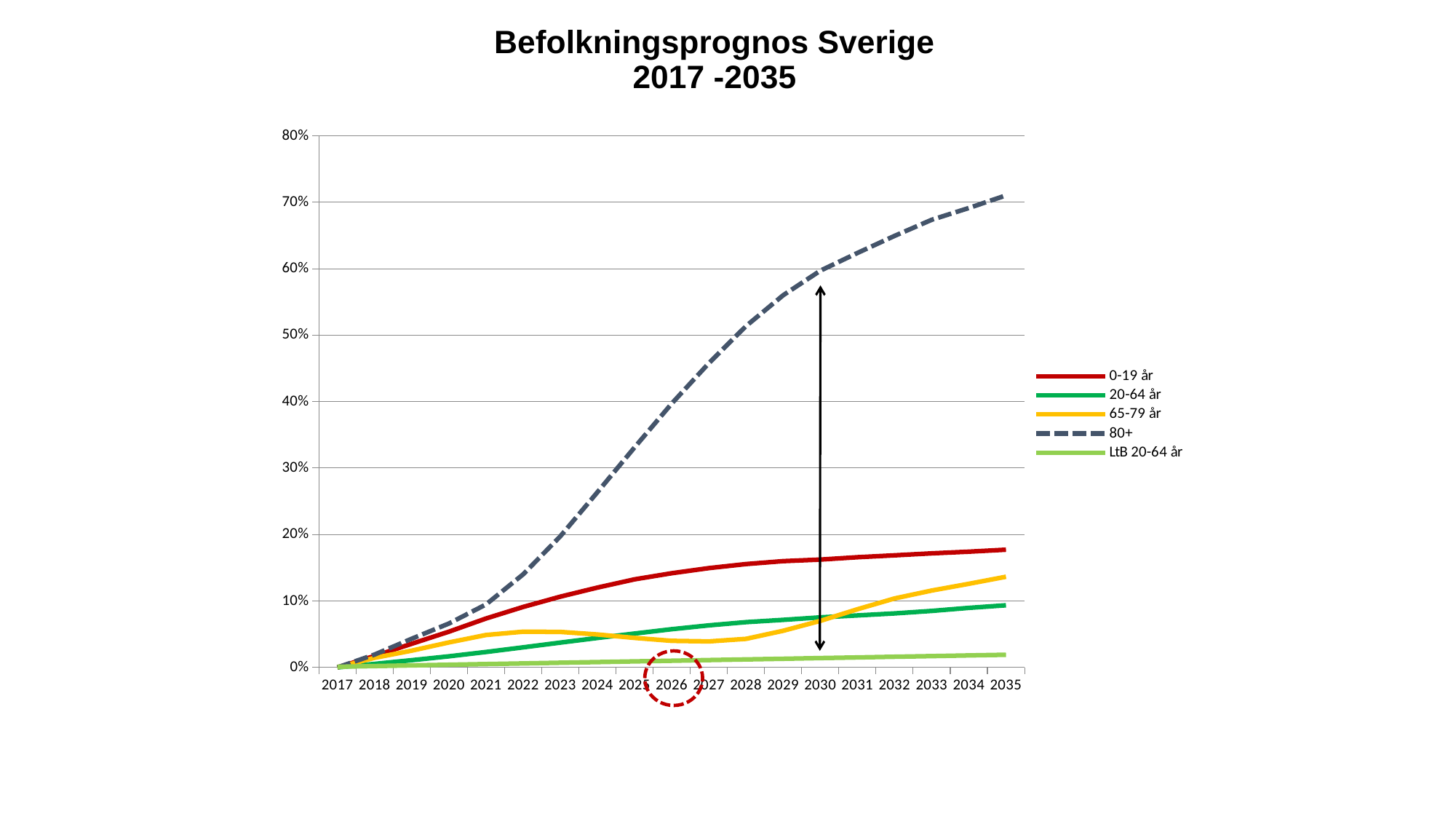
In 2035, which is larger: the value for 0-19 år or the value for 65-79 år? 0-19 år Which series has the highest value in 2035? 80+ Is the value for 80+ in 2025 greater or less than 40%? less Which series has the lowest value in 2035? LtB 20-64 år Is the value for 80+ in 2030 greater or less than 50%? greater Is the value for 0-19 år in 2035 greater or less than 20%? less How many series does the legend list? 5 Which series is drawn with a dashed line? 80+ Does the 80+ series rise or fall from 2017 to 2035? rises How many years are shown along the x axis? 19 What kind of chart is shown on the slide? line chart